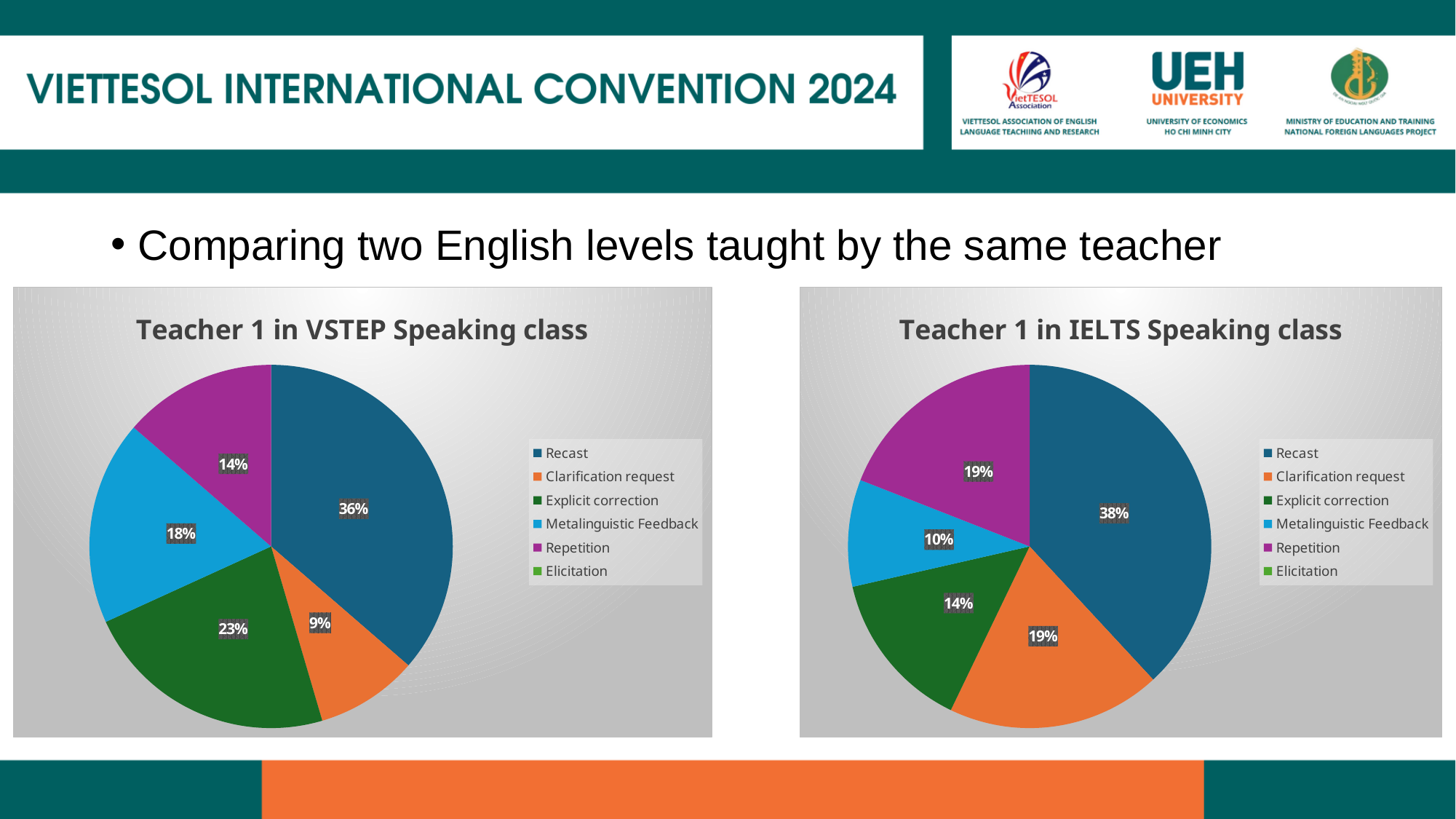
In the 'Teacher 1 in VSTEP Speaking class' chart, which labelled category has the largest share? Recast In the 'Teacher 1 in VSTEP Speaking class' chart, which labelled slice has the smallest share? Clarification request In the 'Teacher 1 in VSTEP Speaking class' chart, what share does Metalinguistic Feedback have? 18% Which is larger: Explicit correction in the VSTEP chart or Explicit correction in the IELTS chart? VSTEP chart In the 'Teacher 1 in IELTS Speaking class' chart, which labelled slice has the smallest share? Metalinguistic Feedback In the 'Teacher 1 in VSTEP Speaking class' chart, what share does Recast have? 36% What is the difference between the Recast share in the IELTS chart and the Recast share in the VSTEP chart? 2% In the 'Teacher 1 in IELTS Speaking class' chart, what share does Explicit correction have? 14% In the 'Teacher 1 in IELTS Speaking class' chart, what share does Clarification request have? 19% How many entries does the legend of the 'Teacher 1 in VSTEP Speaking class' chart list? 6 What type of chart is 'Teacher 1 in IELTS Speaking class'? Pie chart In the 'Teacher 1 in VSTEP Speaking class' chart, what is the difference between Explicit correction and Repetition? 9%